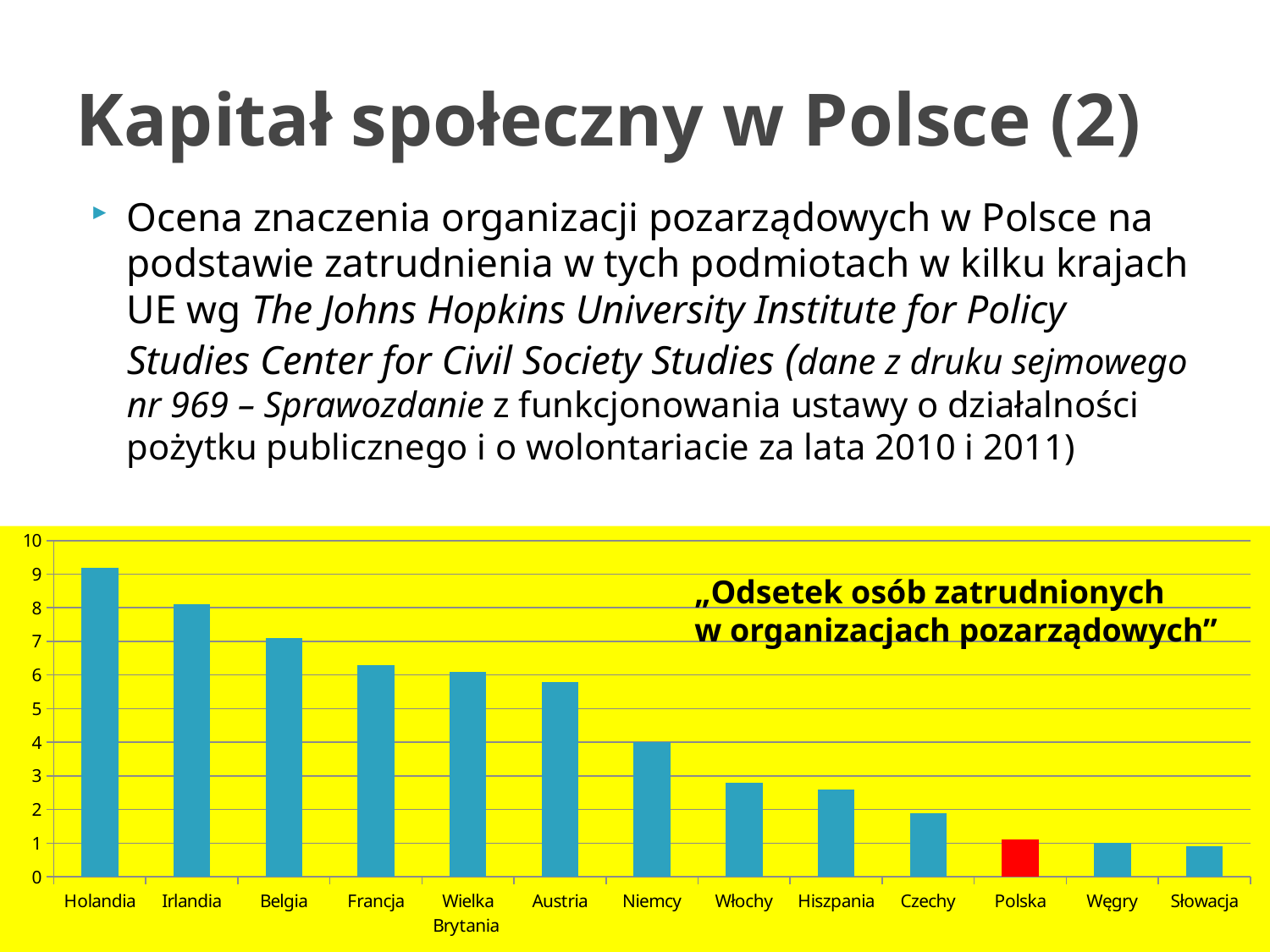
Is the value for Austria greater or less than 6? less Which country has the highest value in the chart? Holandia Is the value for Polska greater or less than 2? less What kind of chart is shown on the slide? bar chart Is the value for Francja greater or less than 6? greater Which has a larger value, Niemcy or Włochy? Niemcy How many countries are shown on the x axis of the chart? 13 Do the values rise or fall moving from left to right along the x axis? fall Which country's bar is coloured red instead of blue? Polska